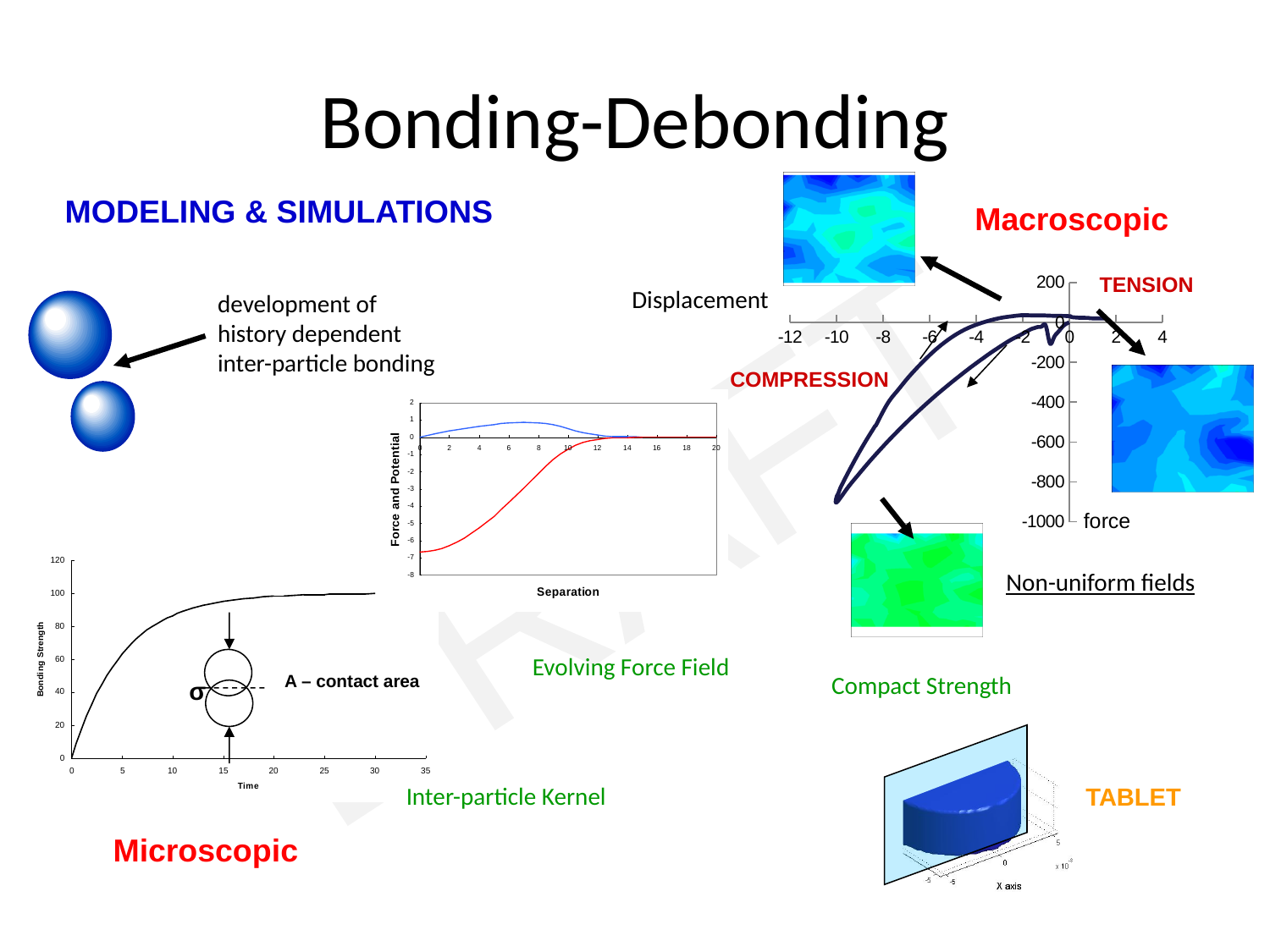
In the bottom-left chart, is the Bonding Strength at Time 5 greater or less than 80? less What is the label of the x axis of the bottom-left chart? Time In the middle chart with the Separation axis, is the value of the red line at Separation 0 greater or less than -4? less What kind of chart is the bottom-left chart with the Time axis? line chart How many lines are plotted in the middle chart with the Separation axis? 2 What is the highest tick value shown on the vertical axis of the force chart on the right? 200 What is the lowest tick value shown on the vertical axis of the force chart on the right? -1000 What is the highest tick value shown on the y axis of the bottom-left chart? 120 What is the label of the x axis of the force chart on the right? Displacement In the bottom-left chart, does Bonding Strength rise or fall as Time increases? rises In the bottom-left chart, is the Bonding Strength at Time 30 greater or less than 80? greater